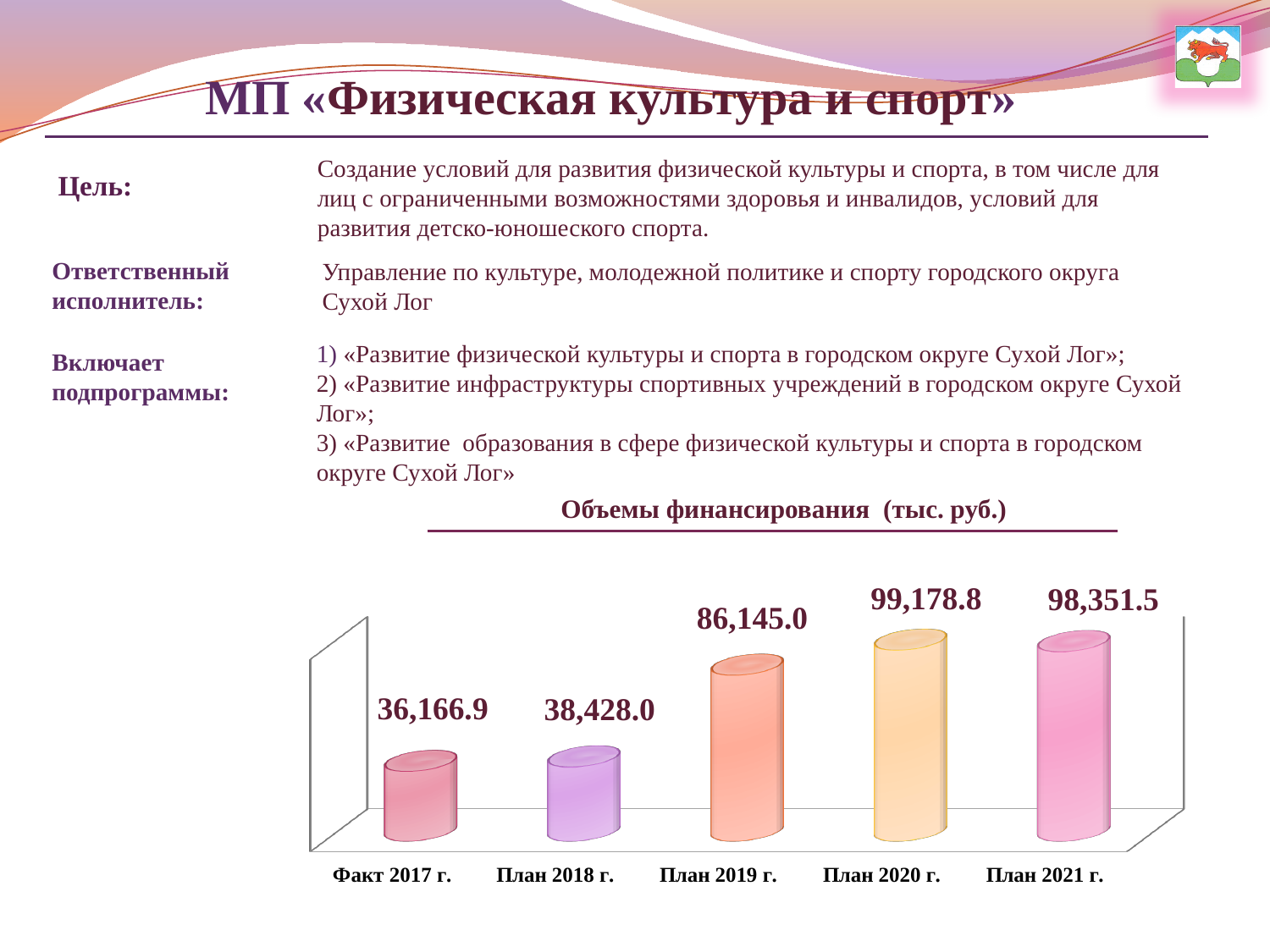
Which category has the lowest value in the chart? Факт 2017 г. What kind of chart is shown on the slide? Bar chart What is the title of the chart? Объемы финансирования (тыс. руб.) How many categories are shown in the chart? 5 What is the difference between the values for План 2020 г. and План 2021 г.? 827.3 Which is larger, the value for План 2020 г. or План 2021 г.? План 2020 г. What is the value for Факт 2017 г. in the chart? 36,166.9 What is the difference between the values for План 2018 г. and Факт 2017 г.? 2,261.1 What is the value for План 2021 г. in the chart? 98,351.5 Which category has the highest value in the chart? План 2020 г. What is the value for План 2019 г. in the chart? 86,145.0 Do the values rise or fall from Факт 2017 г. to План 2020 г.? Rise